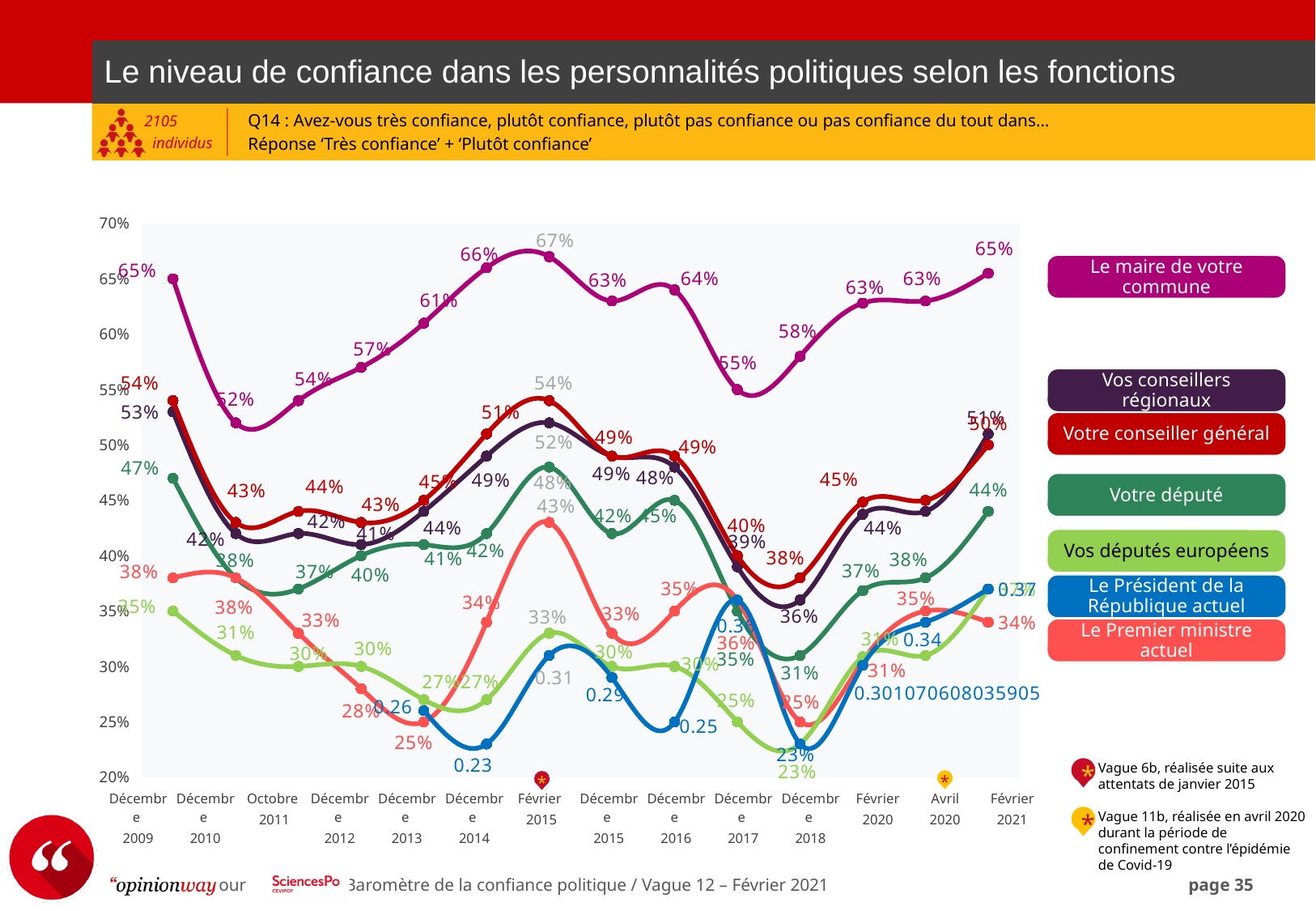
What is the value for 'Le maire de votre commune' in Février 2015? 67% How many series does the legend list? 7 How many survey waves (points) are shown along the x axis? 14 What is the difference between the value for 'Le maire de votre commune' in Février 2015 and in Décembre 2017? 12 percentage points Is the value for 'Le maire de votre commune' in Décembre 2017 greater or less than 60%? less Which series has the highest values across the whole chart? Le maire de votre commune What kind of chart is shown on the slide? line chart In which wave does 'Le maire de votre commune' reach its highest value? Février 2015 In which wave does 'Le maire de votre commune' reach its lowest value? Décembre 2010 What is the value for 'Votre député' in Février 2021? 44% What is the value for 'Le Premier ministre actuel' in Février 2021? 34% What is the value for 'Le maire de votre commune' in Février 2021? 65%